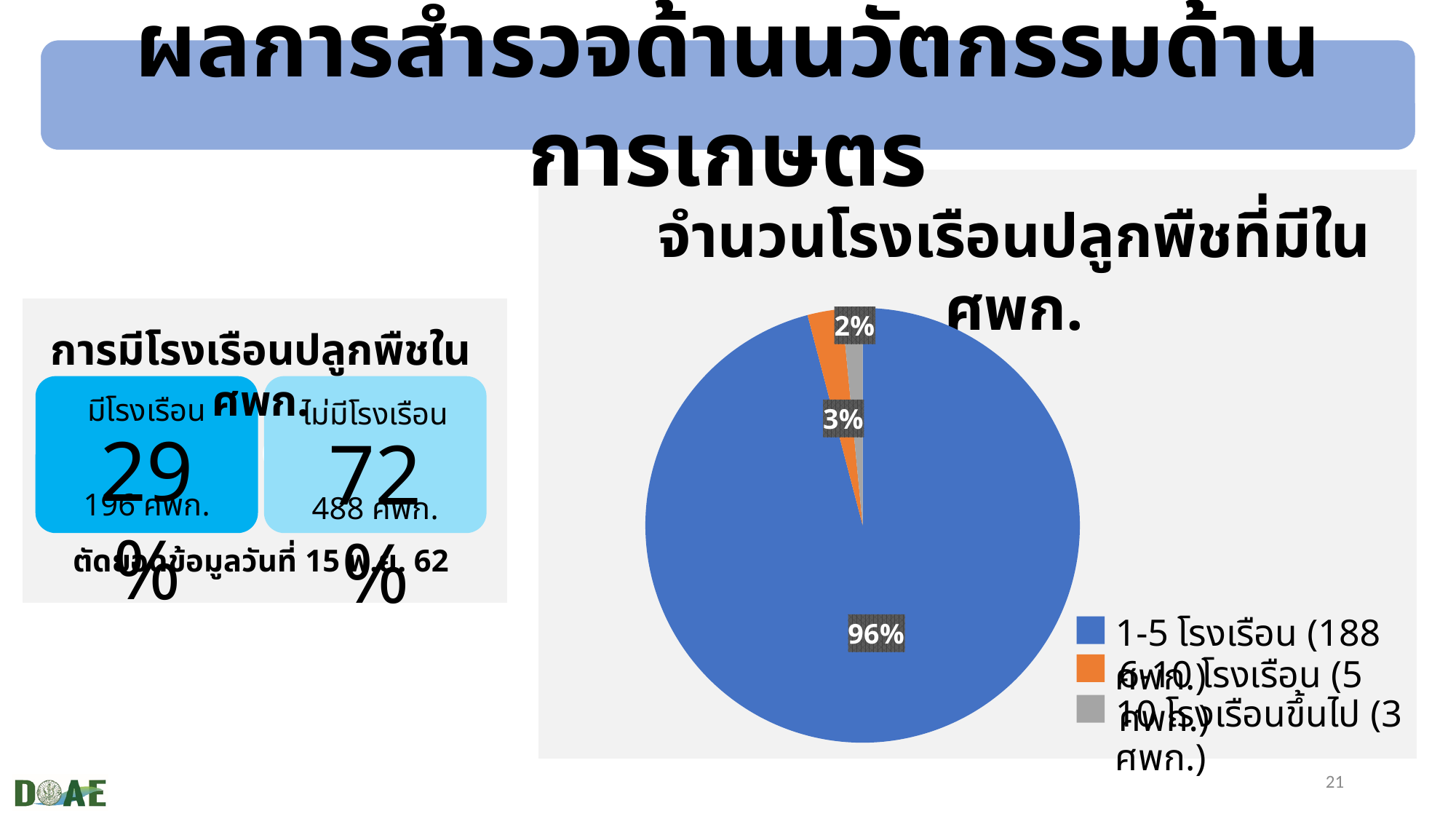
What percentage does the pie chart show for 6-10 โรงเรือน? 3% How many entries does the pie chart's legend list? 3 What percentage does the pie chart show for 10 โรงเรือนขึ้นไป? 2% How many slices does the pie chart have? 3 Which slice is larger in the pie chart: 6-10 โรงเรือน or 10 โรงเรือนขึ้นไป? 6-10 โรงเรือน What percentage does the pie chart show for 1-5 โรงเรือน? 96% What colour is the 6-10 โรงเรือน slice in the pie chart? orange What kind of chart is shown on the slide? pie chart Which category has the largest slice in the pie chart? 1-5 โรงเรือน Which category has the smallest slice in the pie chart? 10 โรงเรือนขึ้นไป What is the difference in percentage points between the 1-5 โรงเรือน slice and the 6-10 โรงเรือน slice? 93 What is the title of the pie chart? จำนวนโรงเรือนปลูกพืชที่มีใน ศพก.